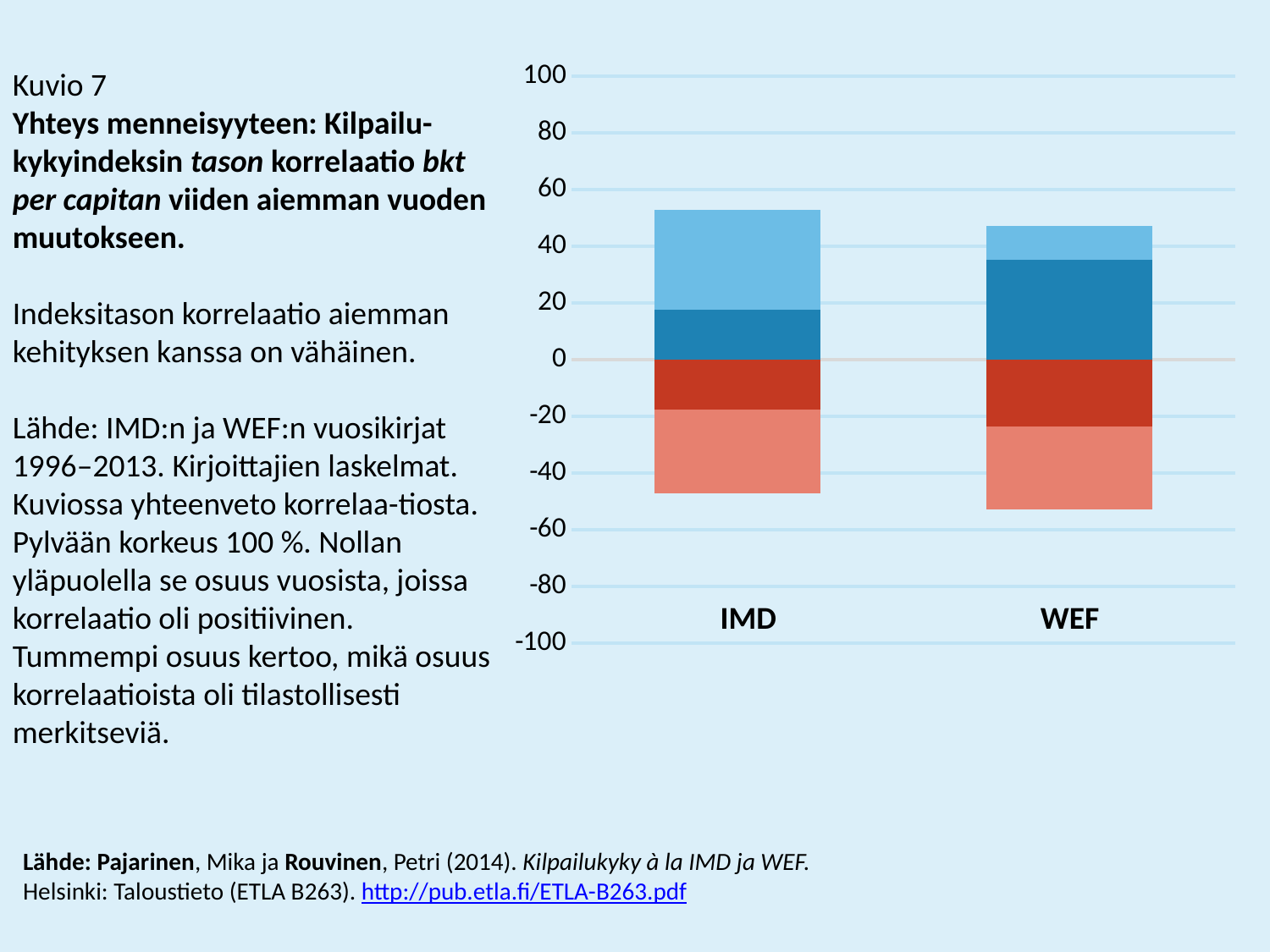
Which category has the larger dark blue segment, IMD or WEF? WEF What is the highest value shown on the vertical axis of the chart? 100 Is the top of the positive (blue) stack for IMD greater or less than 40? greater Is the top of the dark blue segment for WEF greater or less than 20? greater What kind of chart is shown on the slide? stacked bar chart Is the bottom of the negative (red) stack for WEF greater or less than -60? greater Which category's positive (blue) stack reaches higher, IMD or WEF? IMD Which category's negative (red) stack extends further below zero, IMD or WEF? WEF What are the two category labels on the x axis of the chart? IMD and WEF How many categories are shown on the x axis of the chart? 2